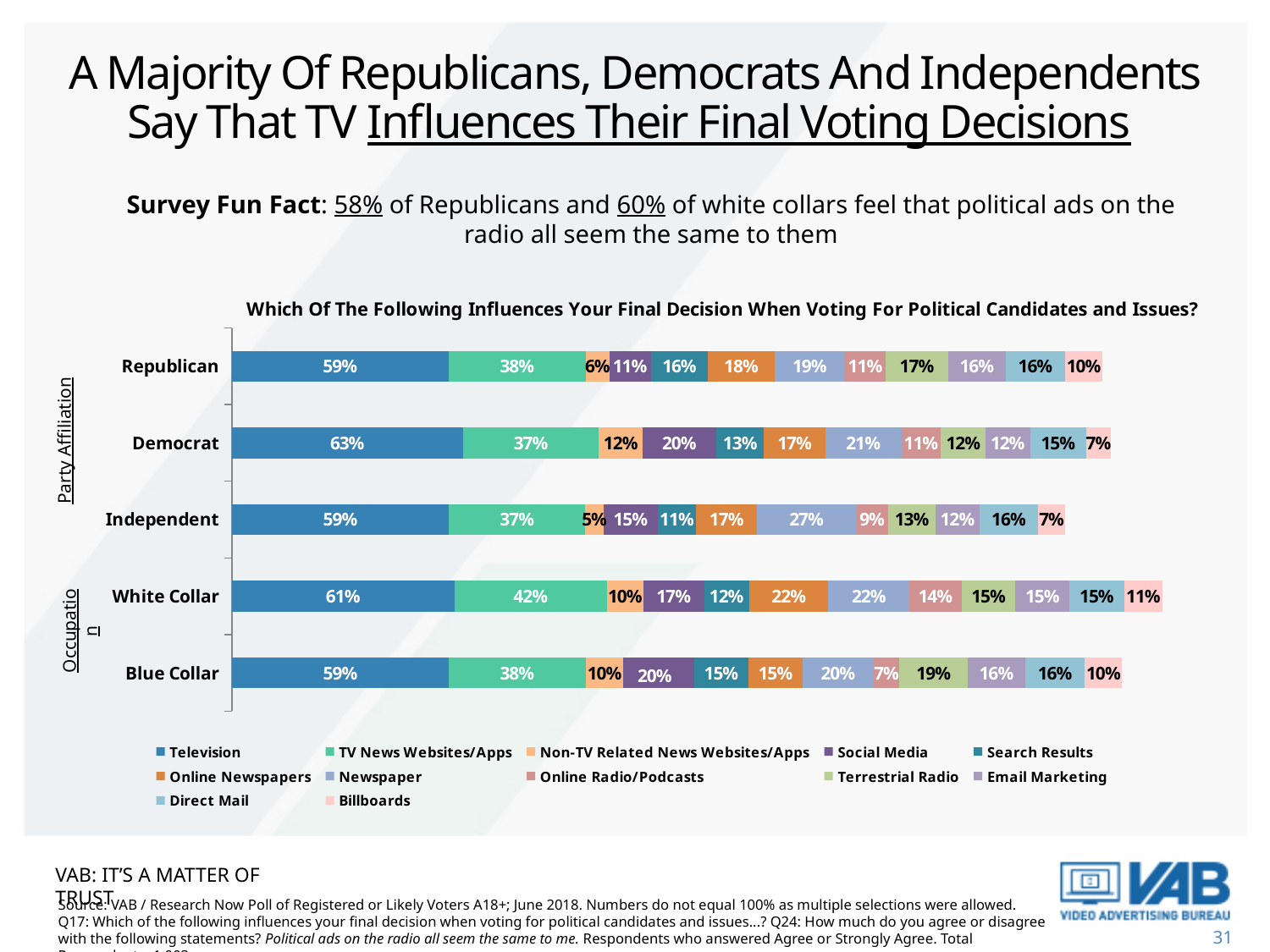
What is the title of the chart? Which Of The Following Influences Your Final Decision When Voting For Political Candidates and Issues? What is the Newspaper value for Independents? 27% What kind of chart is shown on the slide? Stacked bar chart How many series does the legend list? 12 What is the Online Newspapers value for White Collar respondents? 22% What percentage of Democrats say Television influences their final voting decision? 63% How many groups (categories) are shown on the chart? 5 What is the Billboards value for Democrats? 7% Which is larger, the Social Media value for Democrats or for Republicans? Democrat What is the TV News Websites/Apps value for White Collar respondents? 42% Which group has the highest value for Television? Democrat What is the difference between the Television values for Democrats and Republicans? 4 percentage points